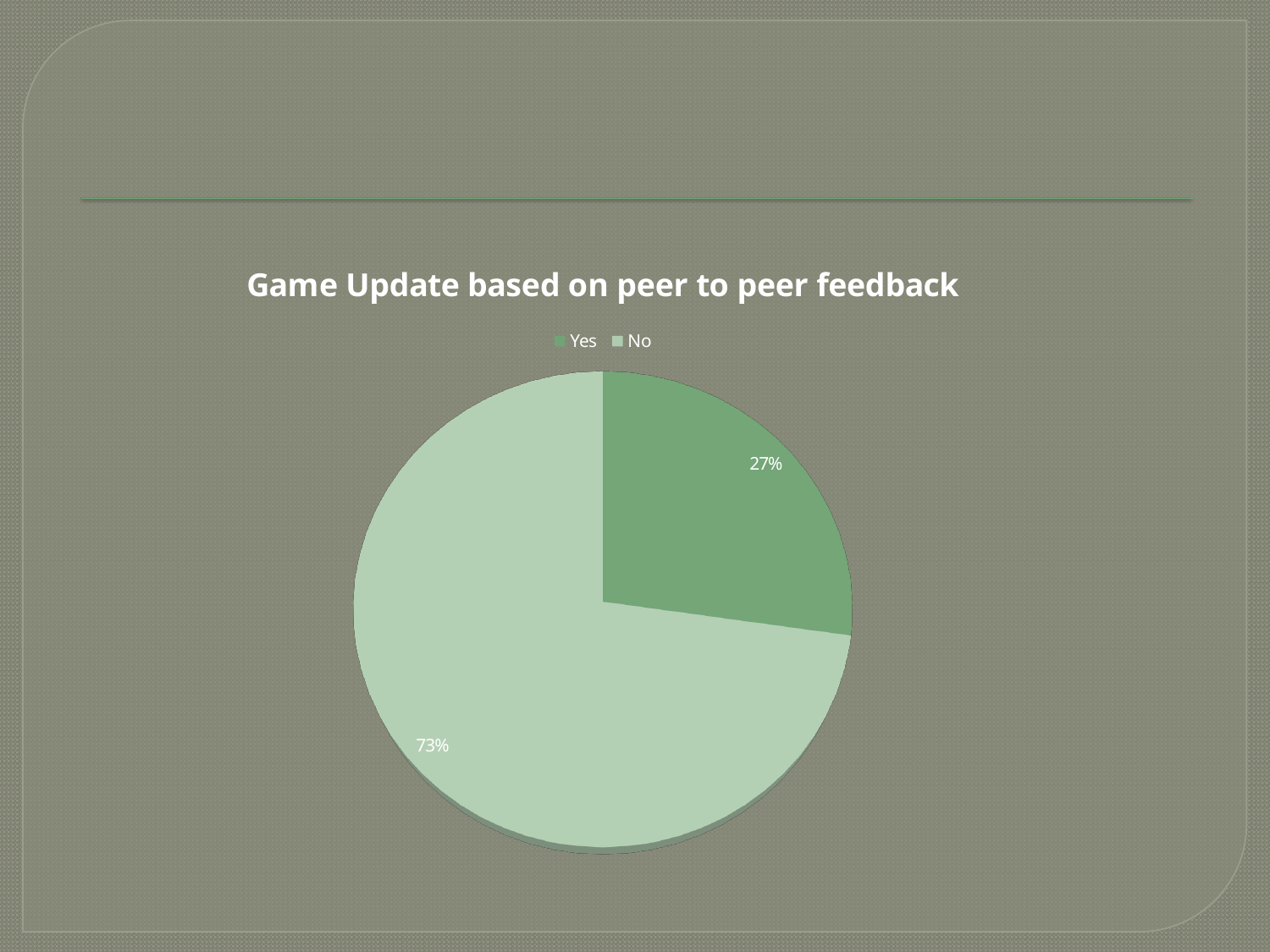
What share of the pie is labelled "Yes"? 27% Which slice is the largest? No What are the legend entries of the chart? Yes, No Which is larger, the "Yes" slice or the "No" slice? No How many entries does the legend list? 2 What is the difference in percentage points between the "No" slice and the "Yes" slice? 46 What is the title of the chart? Game Update based on peer to peer feedback What kind of chart is shown on the slide? pie chart Which slice is the smallest? Yes What share of the pie is labelled "No"? 73% How many slices does the pie chart have? 2